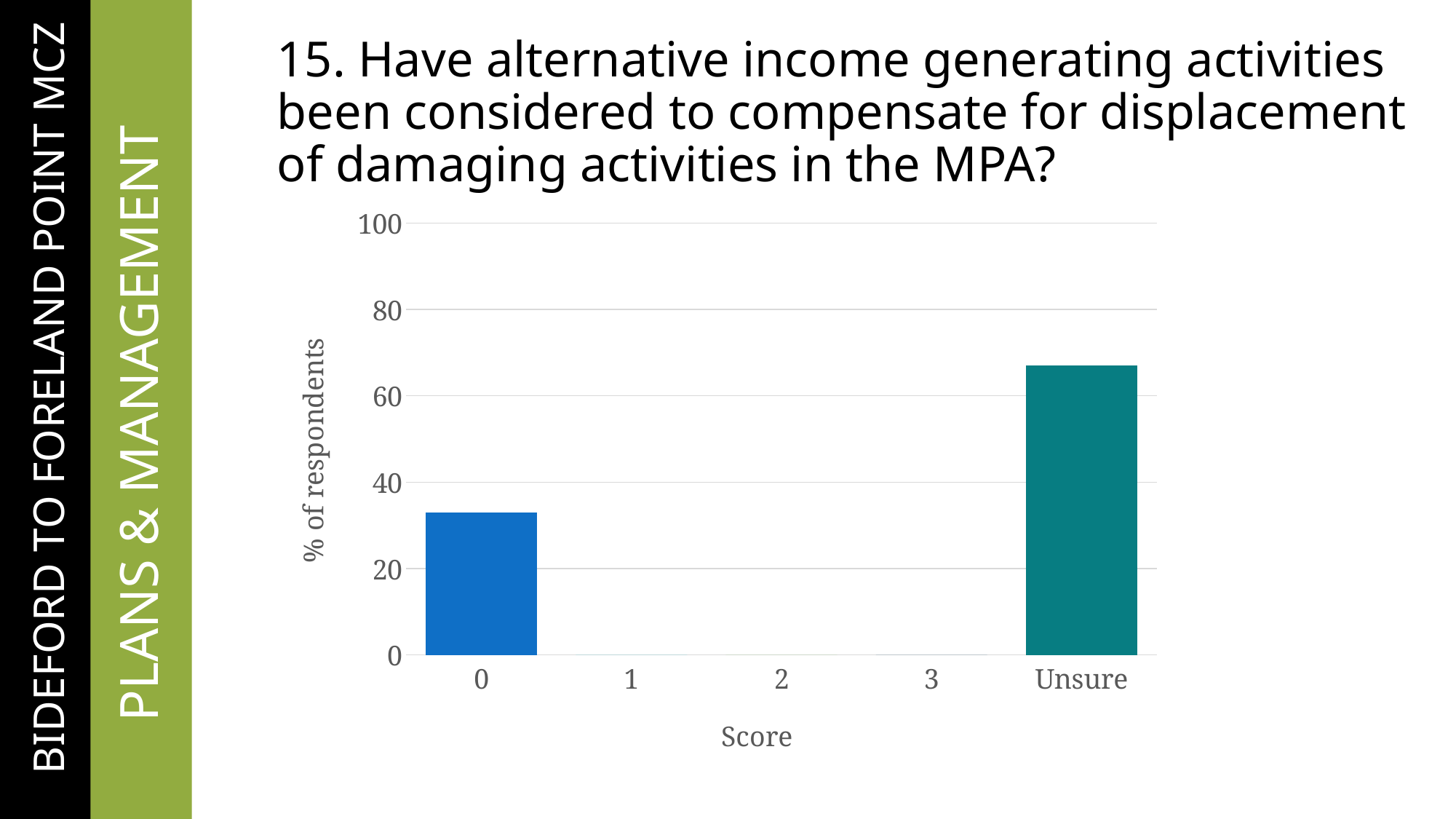
What kind of chart is shown on the slide? bar chart Is the value for Unsure greater or less than 80? less Which score category has the highest percentage of respondents? Unsure Which score categories have no visible bar? 1, 2 and 3 What is the label of the x axis? Score What is the label of the y axis? % of respondents Is the value for score 0 greater or less than 20? greater Is the value for score 0 greater or less than 40? less How many score categories are shown on the x axis? 5 Which is larger, the value for score 0 or the value for Unsure? Unsure